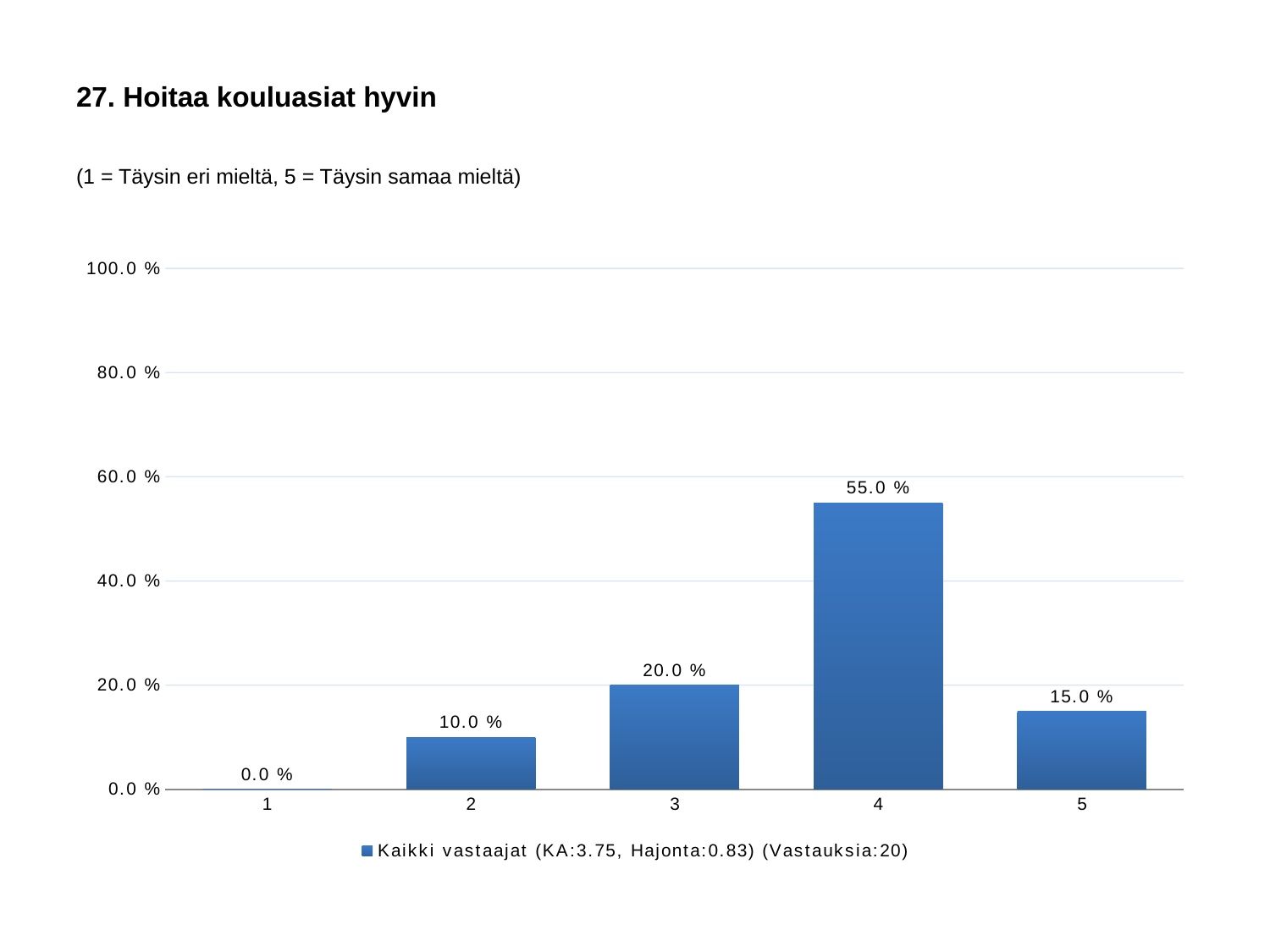
How many categories are shown on the x axis? 5 How many series does the legend list? 1 Which category has the highest value? 4 What is the title of the slide? 27. Hoitaa kouluasiat hyvin What is the value for category 2? 10.0 % Which is larger, the value for category 3 or the value for category 5? 3 Is the value for category 4 greater or less than 40.0 %? greater What is the difference between the values for category 4 and category 3? 35.0 % Which category has the lowest value? 1 What is the value for category 5? 15.0 % What kind of chart is shown on the slide? bar chart What is the value for category 4? 55.0 %